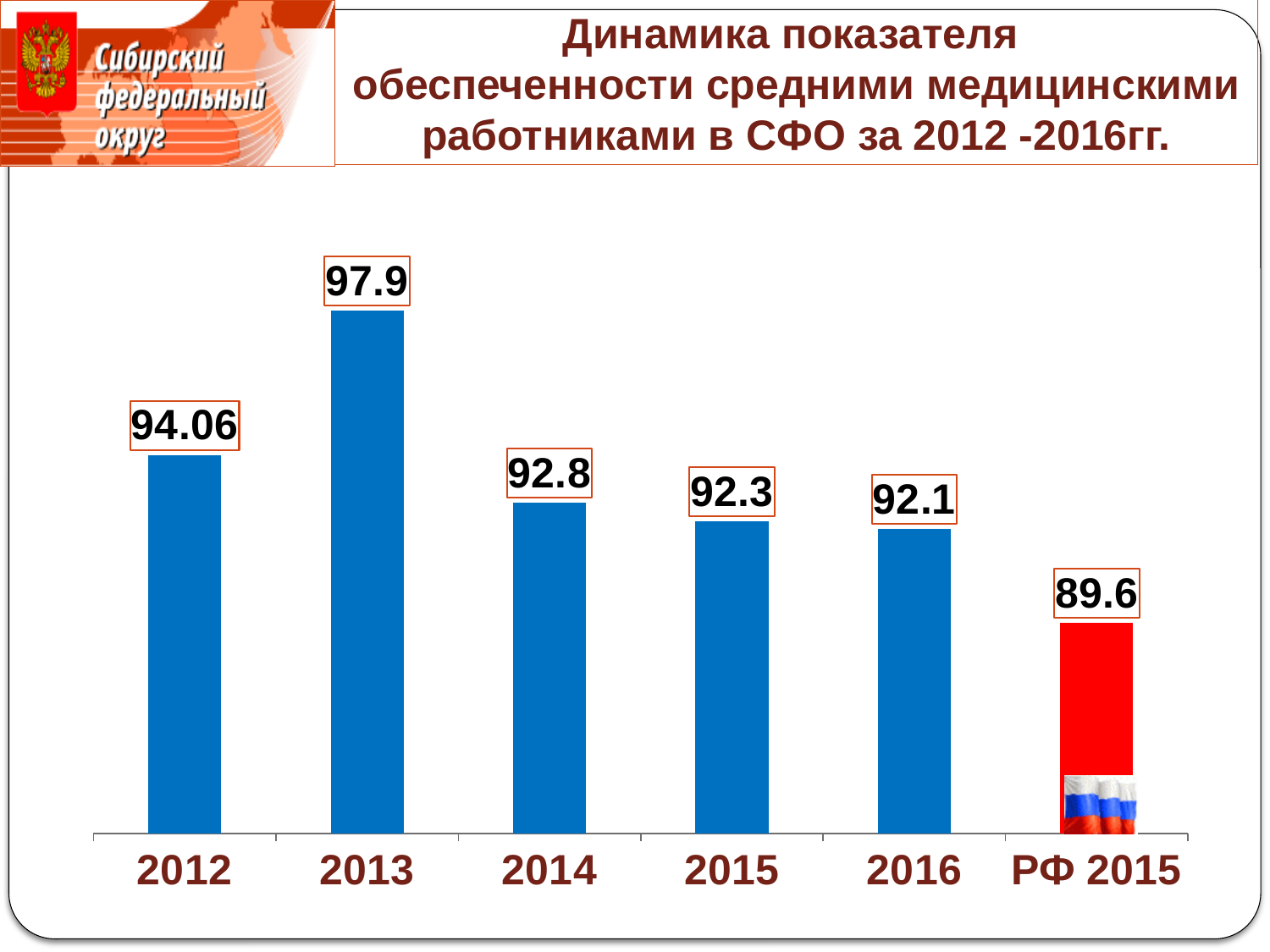
Do the values rise or fall from 2013 to 2016? fall What is the difference between the values for 2013 and 2016? 5.8 What kind of chart is this? bar chart How many categories are shown on the x axis? 6 Which category has the highest value? 2013 Which is larger, the value for 2014 or the value for 2015? 2014 What is the value for 2013? 97.9 Which category has the lowest value? РФ 2015 What is the difference between the values for 2015 and РФ 2015? 2.7 What is the value for 2012? 94.06 What is the value for 2016? 92.1 What is the value for РФ 2015? 89.6